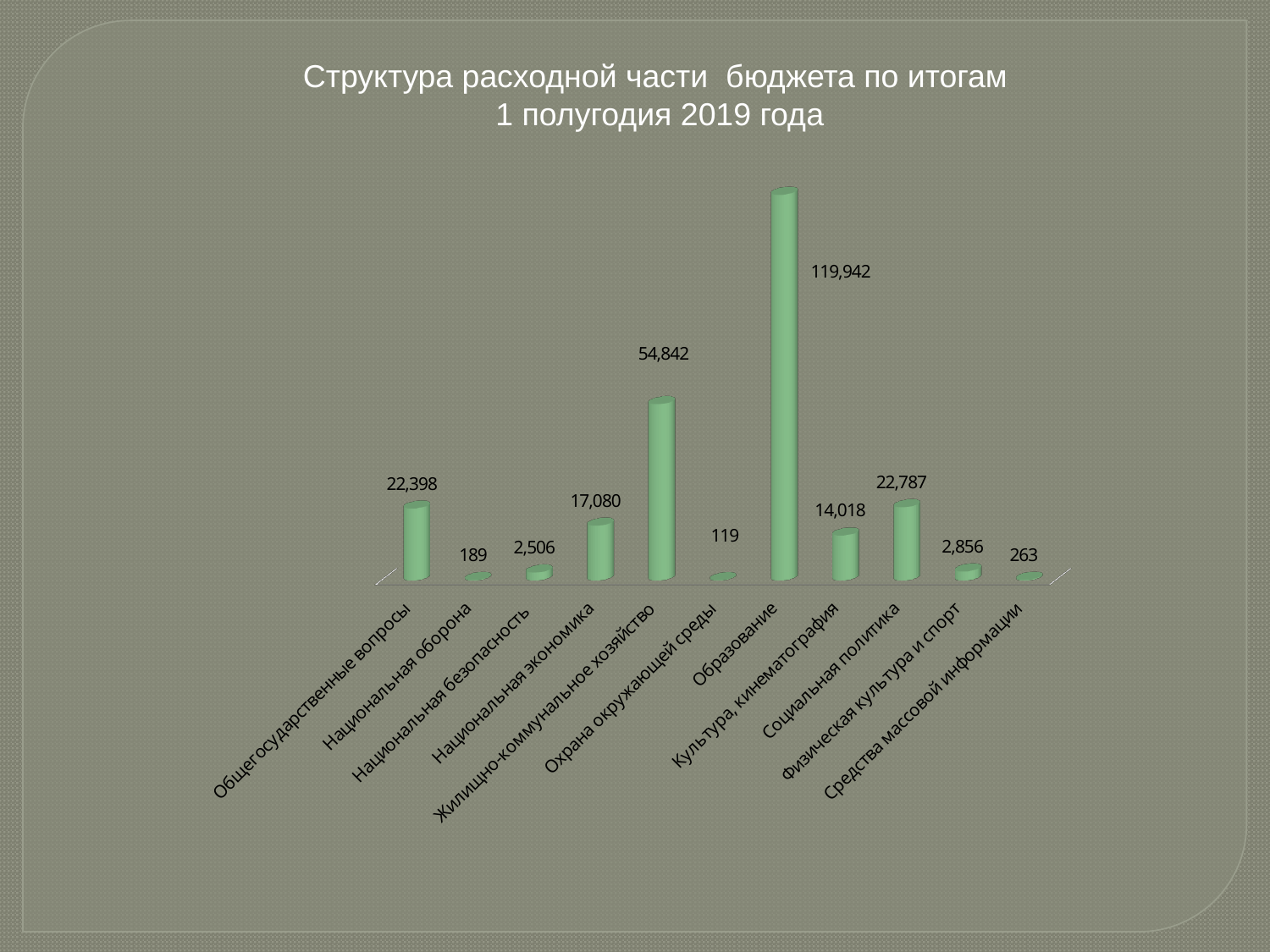
What is the value for Образование? 119,942 Which category has the highest value? Образование What is the difference between the values for Образование and Жилищно-коммунальное хозяйство? 65,100 Which category has the lowest value? Охрана окружающей среды What is the value for Жилищно-коммунальное хозяйство? 54,842 Which is larger, the value for Национальная экономика or the value for Культура, кинематография? Национальная экономика What is the value for Культура, кинематография? 14,018 What is the difference between the values for Национальная экономика and Культура, кинематография? 3,062 What is the value for Национальная оборона? 189 What type of chart is shown on the slide? Bar chart How many categories are shown in the chart? 11 What is the value for Средства массовой информации? 263